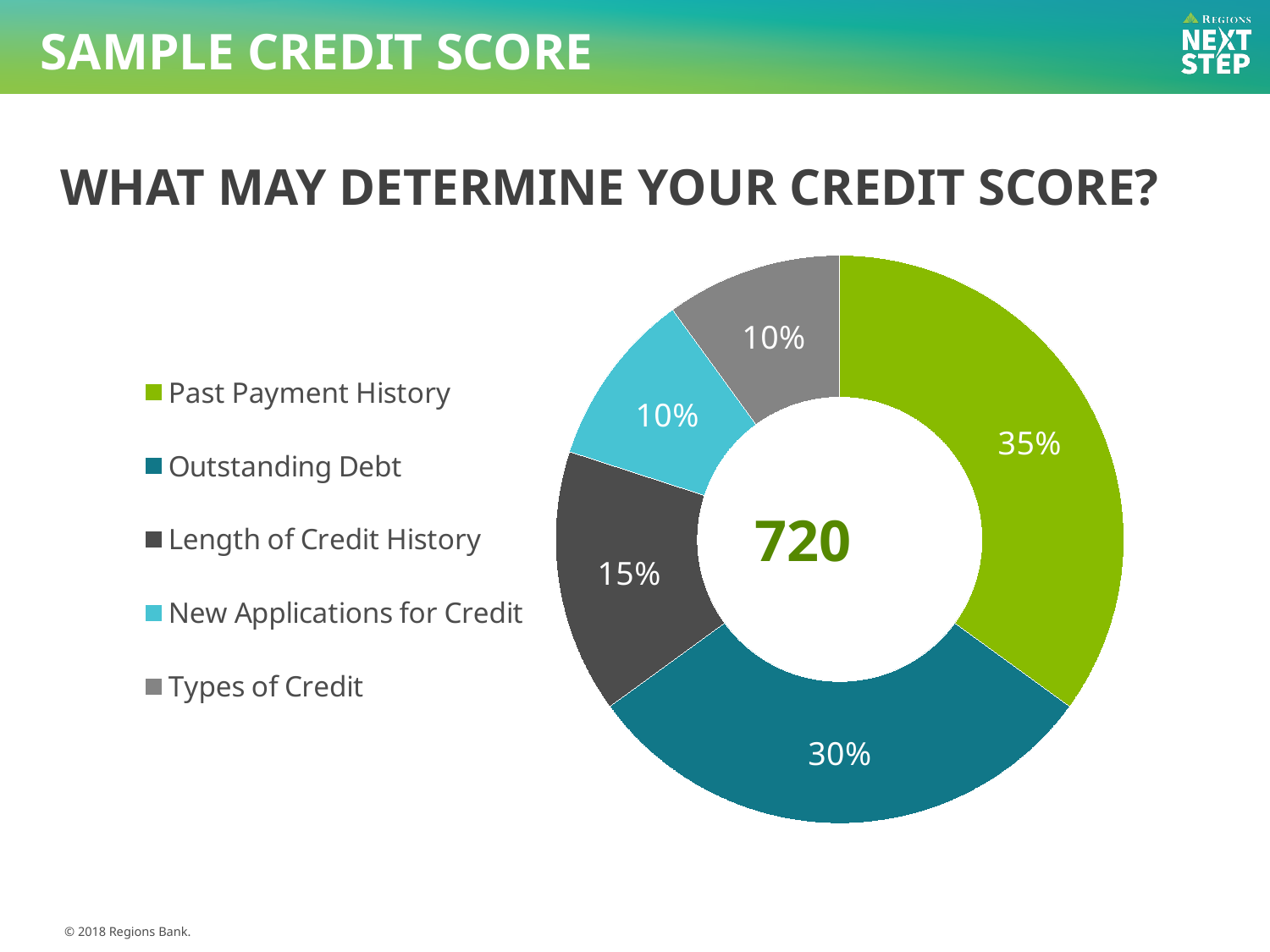
What colour represents Outstanding Debt in the legend? Teal (dark blue-green) What percentage is shown for New Applications for Credit? 10% What is the difference between the shares for Past Payment History and Outstanding Debt? 5% What percentage is shown for Outstanding Debt? 30% Which category has the largest share of the chart? Past Payment History How many categories does the chart show? 5 What kind of chart is shown on the slide? Doughnut (pie) chart What percentage is shown for Types of Credit? 10% What number is displayed in the center of the doughnut chart? 720 What percentage is shown for Past Payment History? 35% Which is larger, the share for Length of Credit History or the share for Types of Credit? Length of Credit History What percentage is shown for Length of Credit History? 15%